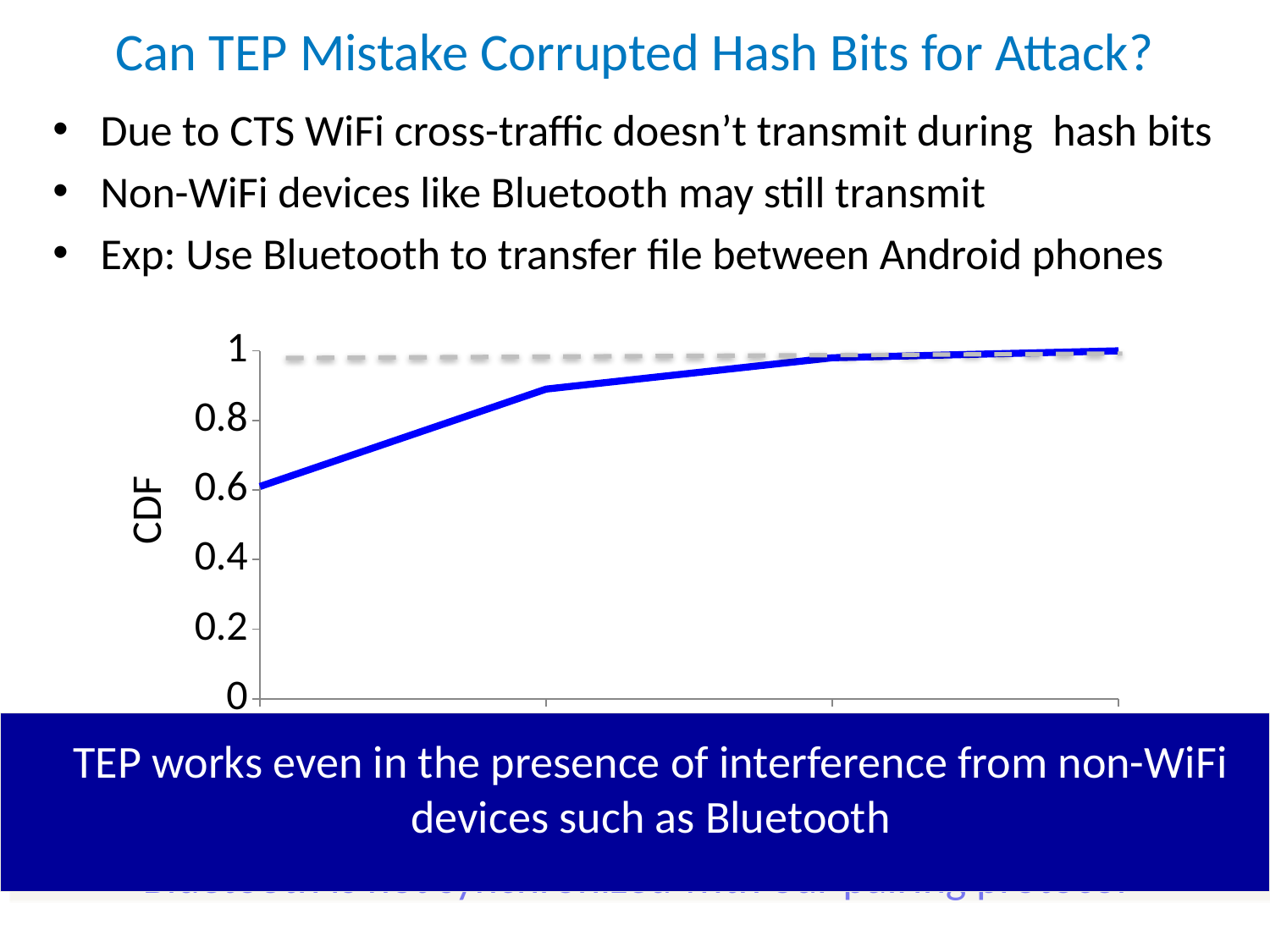
What is the label on the y axis of the chart? CDF Is the value of the solid blue line at the left edge of the chart greater or less than 0.4? greater Is the value of the grey dashed line greater or less than 0.8? greater What is the highest tick value shown on the y axis? 1 How many lines are plotted on the chart? 2 What kind of chart is shown on the slide? line chart Does the solid blue line rise or fall as it moves from left to right along the x axis? rise Is the value of the solid blue line at the left edge of the chart greater or less than 0.8? less